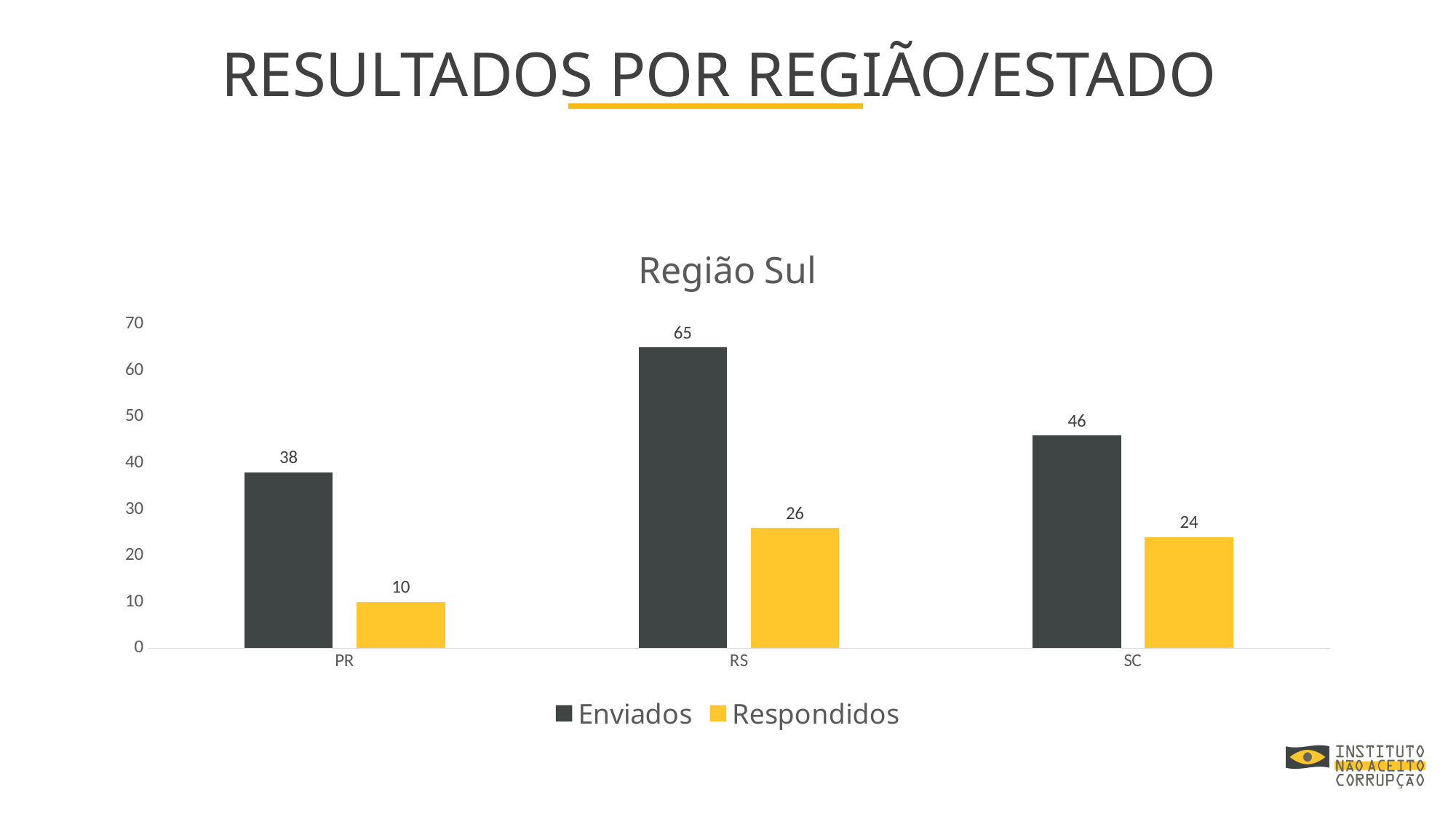
What is the title of the chart? Região Sul What is the difference between the Enviados values for SC and PR? 8 Which state has the highest Enviados value? RS What kind of chart is shown? Bar chart How many states are shown on the x axis? 3 What is the Respondidos value for SC? 24 What is the difference between Enviados and Respondidos for RS? 39 How many series does the legend list? 2 Which state has the lowest Respondidos value? PR What is the Respondidos value for PR? 10 What is the Enviados value for RS? 65 Which is larger, the Respondidos value for RS or for SC? RS